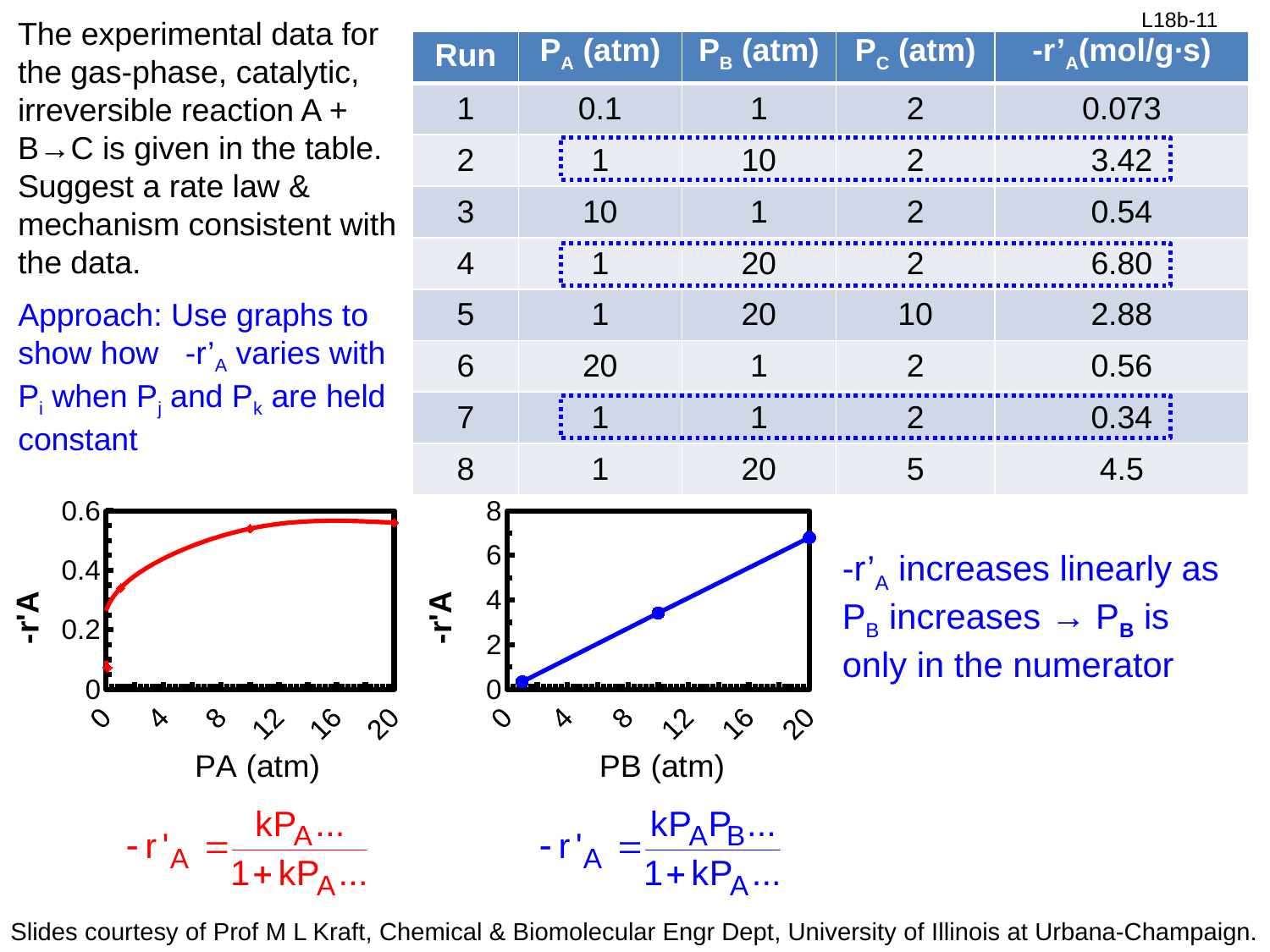
In the left chart (-r'A vs PA), how many data points are plotted? 4 In the right chart (-r'A vs PB), is the value at PB = 10 greater or less than 4? less In the right chart (-r'A vs PB), is the value at PB = 20 greater or less than 6? greater What kind of chart is the left chart (-r'A vs PA)? line chart In the left chart (-r'A vs PA), is the value at PA = 1 greater or less than 0.2? greater In the right chart (-r'A vs PB), at which PB value is -r'A lowest? 1 In the right chart (-r'A vs PB), which is larger: the value at PB = 10 or at PB = 20? PB = 20 In the right chart (-r'A vs PB), how many data points are plotted? 3 What is the x-axis title of the left chart? PA (atm) In the right chart (-r'A vs PB), does -r'A rise or fall as PB increases? rise In the left chart (-r'A vs PA), does -r'A rise or fall as PA increases from 0 to 10? rise